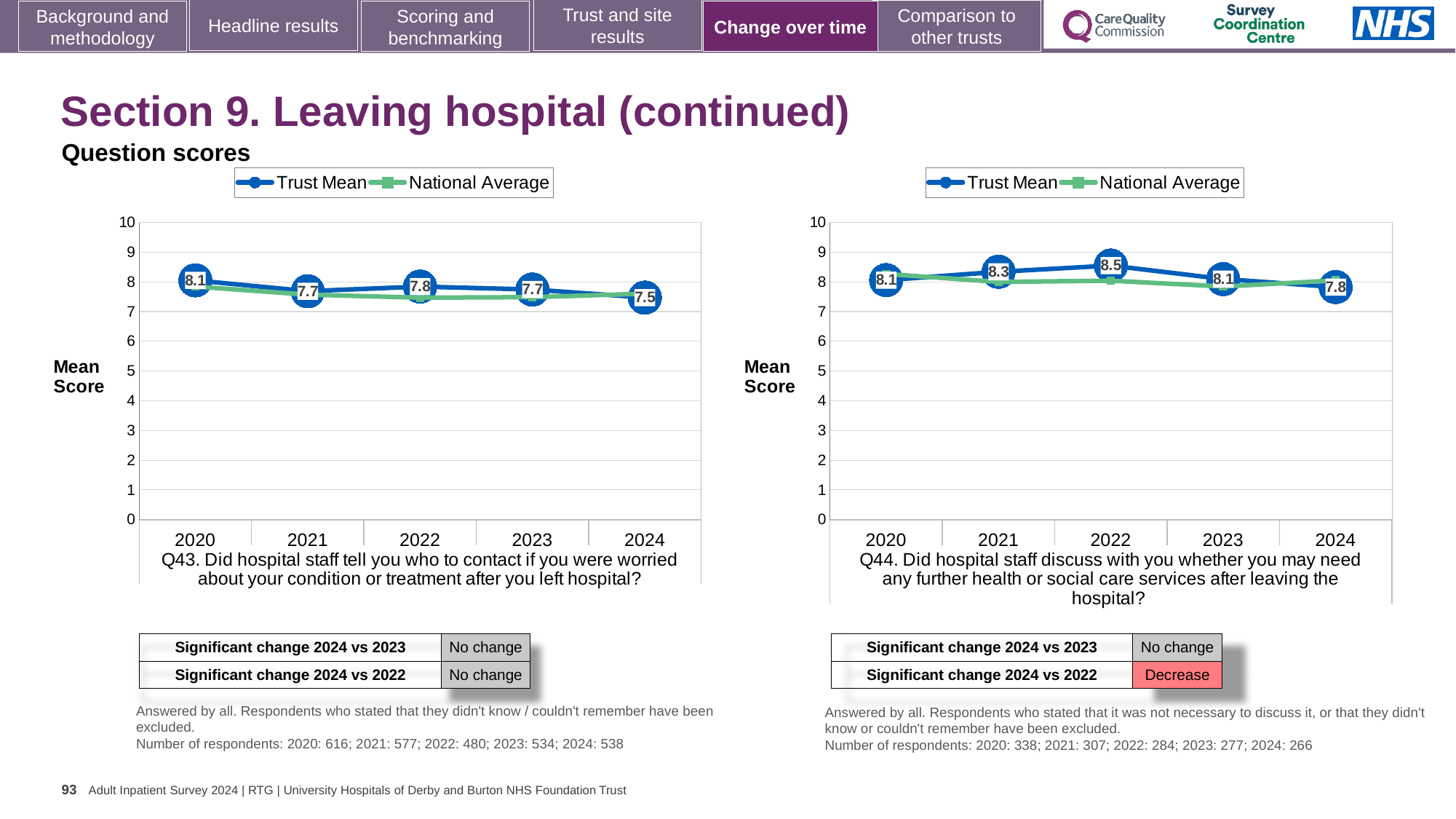
On the Q44 chart (right), what is the difference between the Trust Mean scores for 2022 and 2024? 0.7 On the Q44 chart (right), what is the Trust Mean score for 2022? 8.5 On the Q44 chart (right), what is the Trust Mean score for 2024? 7.8 On the Q44 chart (right), which year has the highest Trust Mean score? 2022 On the Q43 chart (left), which year has the lowest Trust Mean score? 2024 How many years are plotted on the Q44 chart (right)? 5 What kind of chart is the Q44 chart (right)? Line chart On the Q43 chart (left), is the National Average for 2024 greater or less than 5? greater On the Q43 chart (left), what is the Trust Mean score for 2020? 8.1 On the Q43 chart (left), what is the Trust Mean score for 2024? 7.5 On the Q43 chart (left), which is larger, the Trust Mean score for 2020 or for 2021? 2020 How many series does the legend of the Q43 chart (left) list? 2